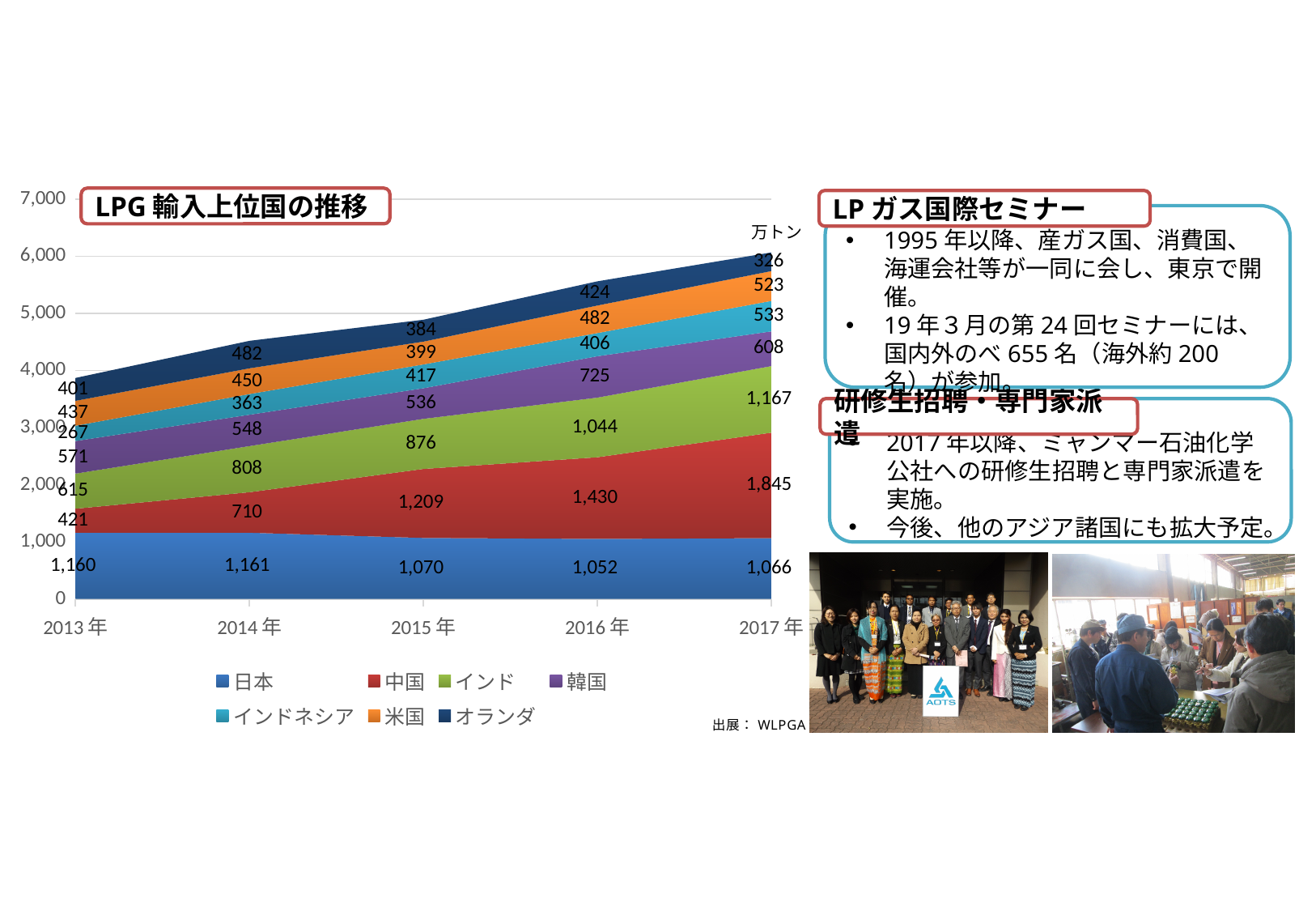
What is the value for インド in 2016 年? 1,044 Which is larger in 2015 年, the value for 日本 or the value for 中国? 中国 What is the value for オランダ in 2015 年? 384 What kind of chart is this? Stacked area chart What is the difference between the 中国 values in 2017 年 and 2013 年? 1,424 In which year is the value for 中国 highest? 2017 年 Does the value for 中国 rise or fall from 2013 年 to 2017 年? Rise In which year is the value for インドネシア lowest? 2013 年 What is the value for 中国 in 2017 年? 1,845 How many years are shown on the x axis? 5 What is the value for 日本 in 2013 年? 1,160 How many series does the legend list? 7